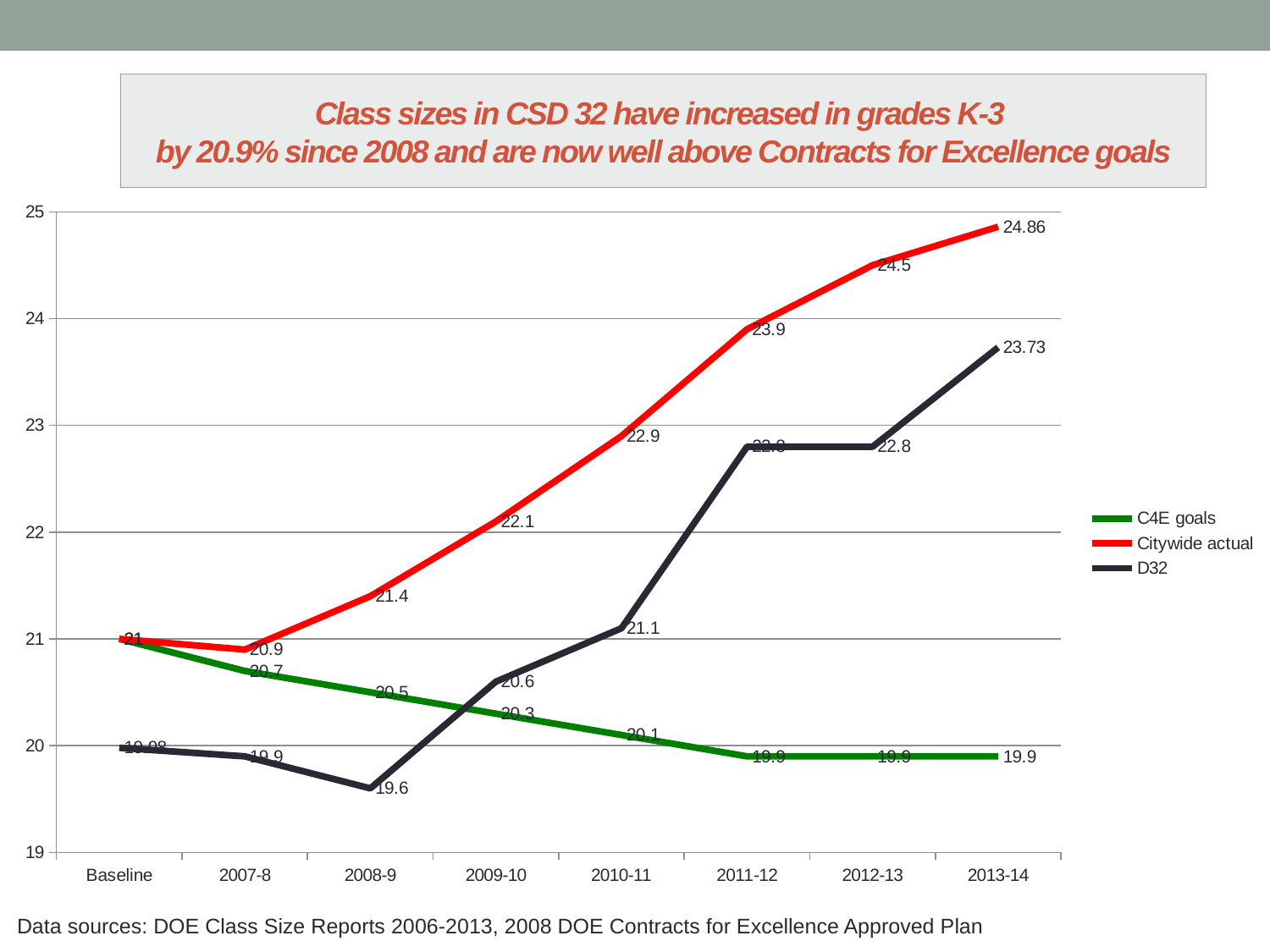
What kind of chart is shown on the slide? line chart What is the D32 value for 2013-14? 23.73 In which year is the D32 value lowest? 2008-9 In which year is the Citywide actual value highest? 2013-14 Which is larger in 2012-13, the Citywide actual value or the D32 value? Citywide actual What is the difference between the Citywide actual and D32 values in 2013-14? 1.13 What is the D32 value for 2008-9? 19.6 How many categories are shown on the x axis? 8 What is the Citywide actual value for 2010-11? 22.9 How many series does the legend list? 3 What is the Citywide actual value for 2013-14? 24.86 Do the C4E goals values rise or fall from Baseline to 2013-14? fall